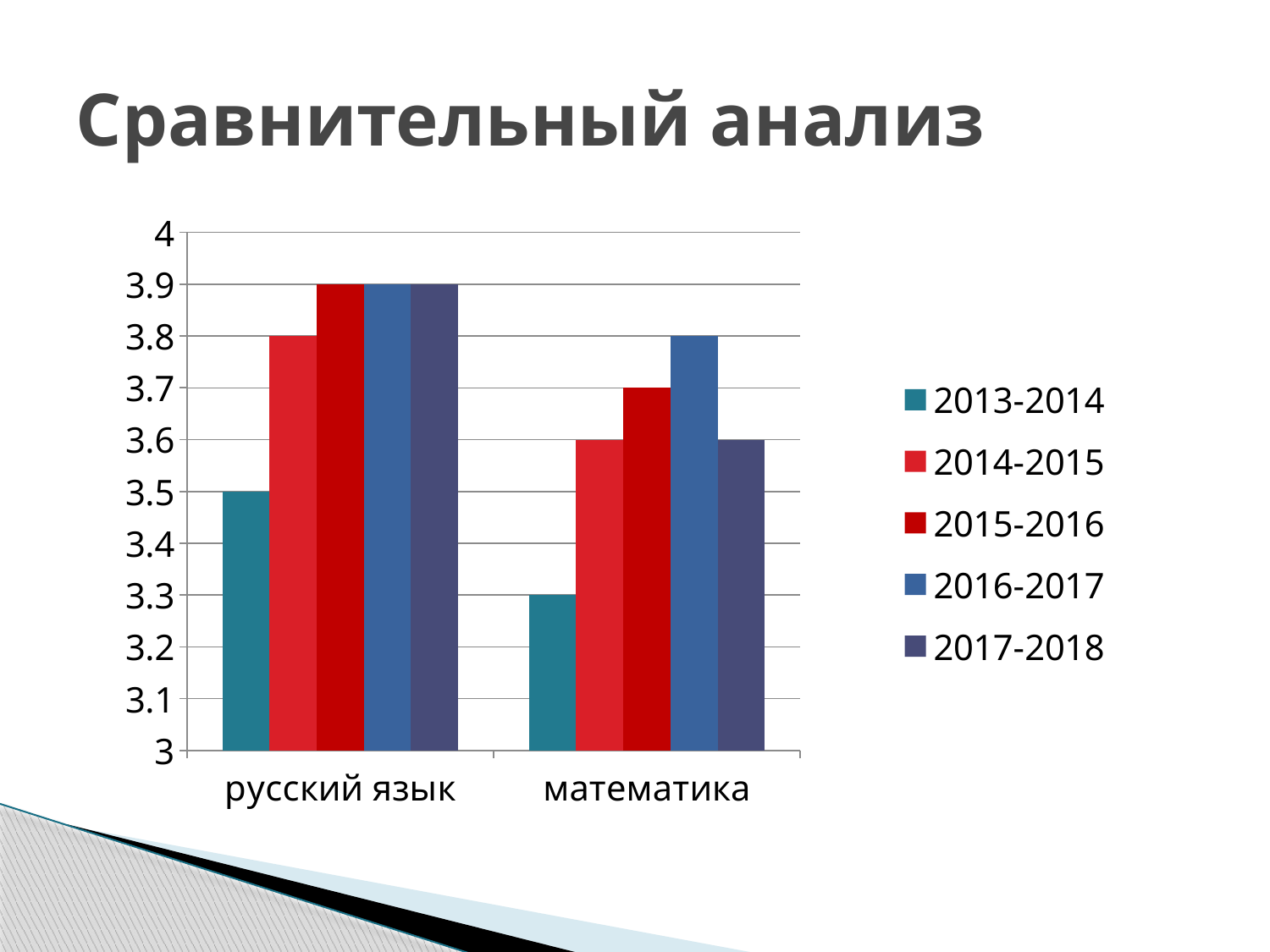
Which series has the highest value for математика? 2016-2017 What is the title of the slide? Сравнительный анализ What is the value for математика in 2016-2017? 3.8 How many categories are shown on the x axis? 2 What kind of chart is shown on the slide? bar chart Which is larger: the 2017-2018 value for русский язык or for математика? русский язык What is the difference between the русский язык and математика values for 2013-2014? 0.2 What is the value for русский язык in 2014-2015? 3.8 Which series has the lowest value for математика? 2013-2014 How many series does the legend list? 5 What is the value for математика in 2013-2014? 3.3 What is the value for русский язык in 2013-2014? 3.5